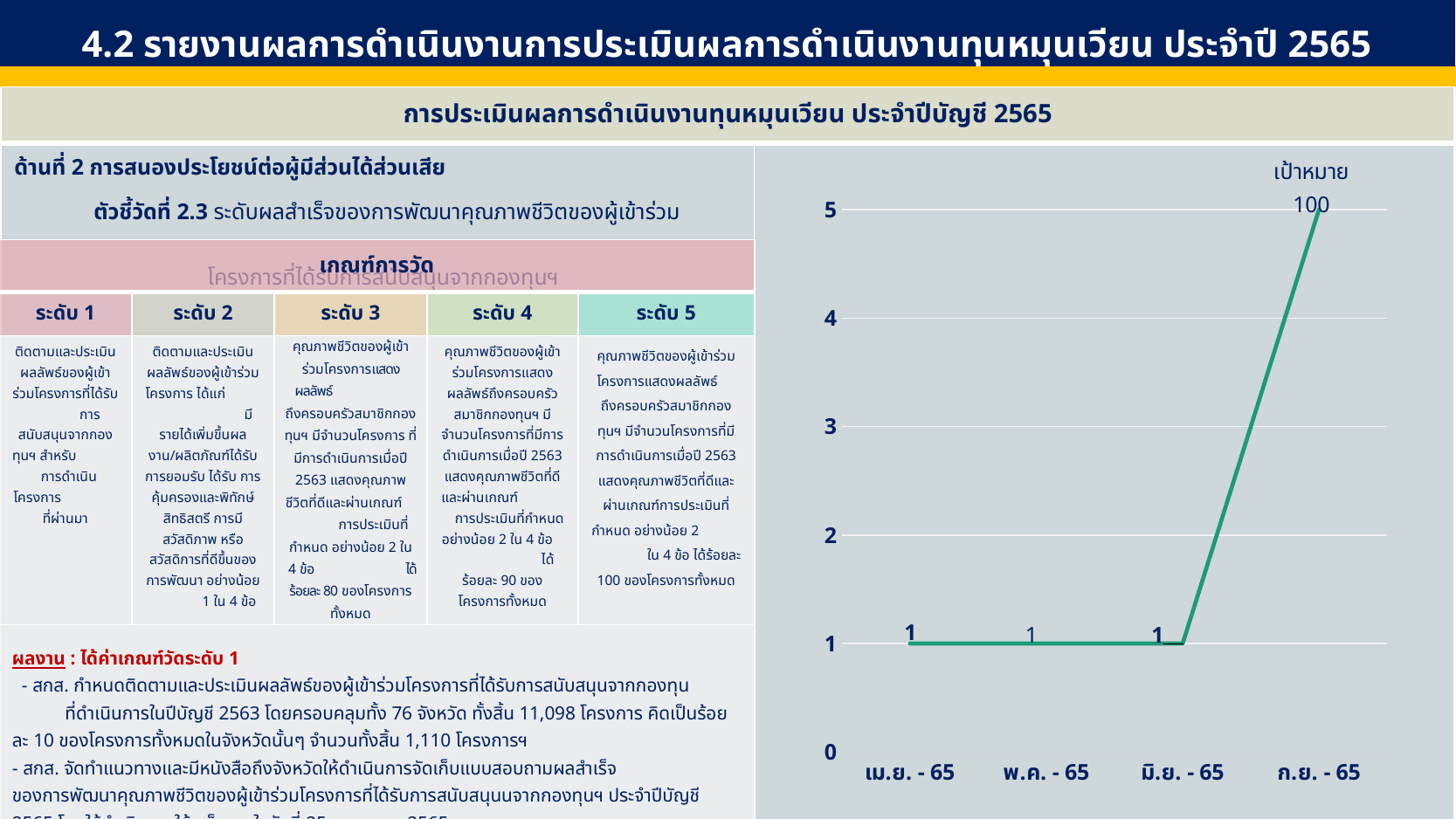
What kind of chart is shown on the right side of the slide? line chart Does the line rise or fall between มิ.ย. - 65 and ก.ย. - 65? rise Which is larger in the line chart, the value for ก.ย. - 65 or the value for เม.ย. - 65? ก.ย. - 65 What is the value for เม.ย. - 65 in the line chart? 1 What is the value for มิ.ย. - 65 in the line chart? 1 Which category has the highest value in the line chart? ก.ย. - 65 What label appears above the last point of the line chart? เป้าหมาย 100 How many categories are shown on the x axis of the line chart? 4 Is the value for มิ.ย. - 65 greater or less than 2? less What is the value for พ.ค. - 65 in the line chart? 1 What is the highest tick value shown on the y axis of the line chart? 5 Is the value for ก.ย. - 65 greater or less than 4? greater